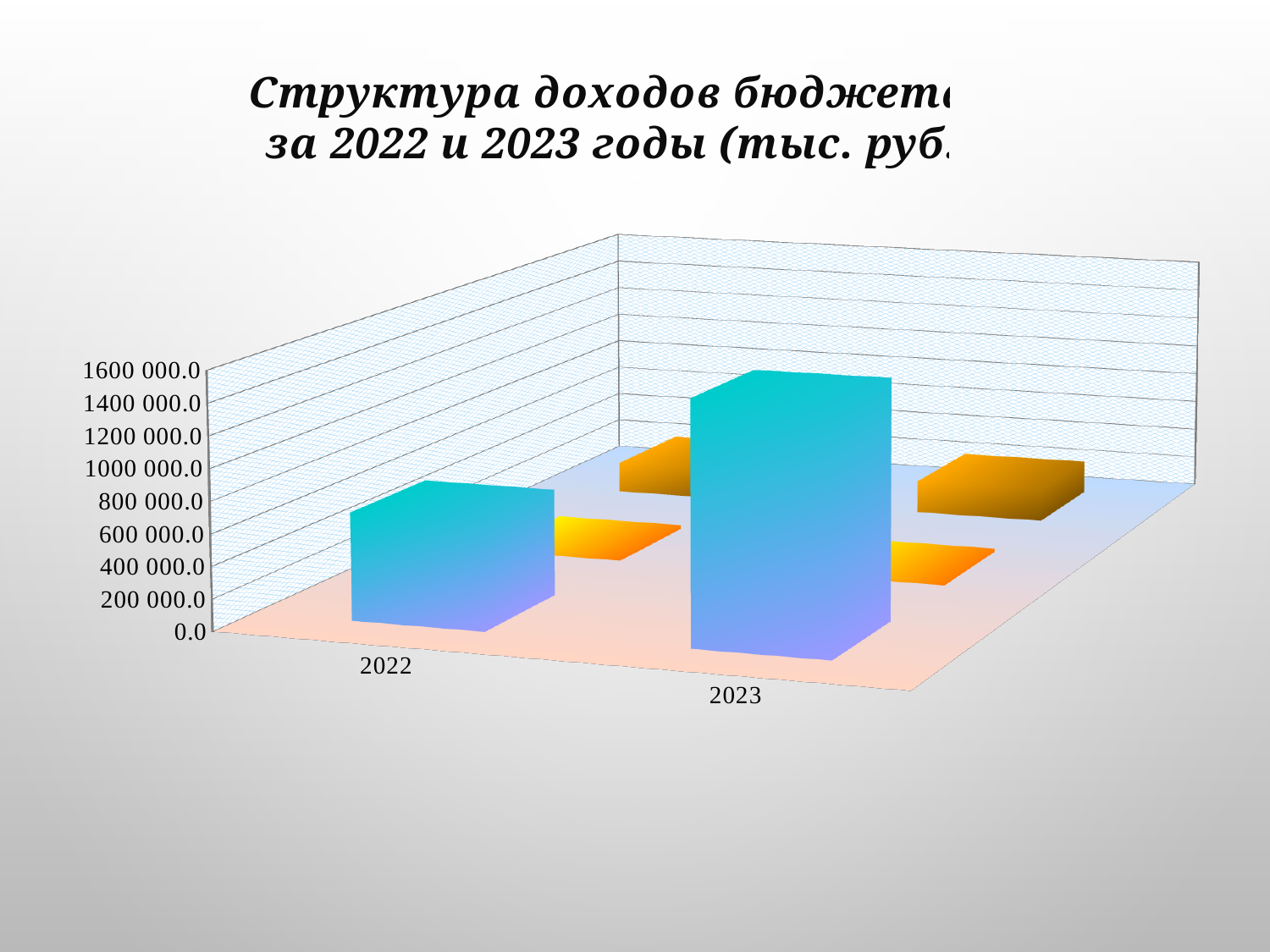
Is the value of the blue bar for 2022 greater or less than 1400 000.0? less Which years are shown as categories on the x axis? 2022 and 2023 Does the blue series rise or fall from 2022 to 2023? rise In 2023, which bar is taller: the blue one or the orange one? the blue one Is the value of the blue bar for 2023 greater or less than 600 000.0? greater How many bars are plotted for each year in the chart? 3 Which year has the tallest bar in the chart? 2023 What kind of chart is shown on the slide? bar chart What is the highest value shown on the vertical axis of the chart? 1600 000.0 How many categories (years) are shown on the x axis of the chart? 2 Is the blue bar for 2023 larger or smaller than the blue bar for 2022? larger